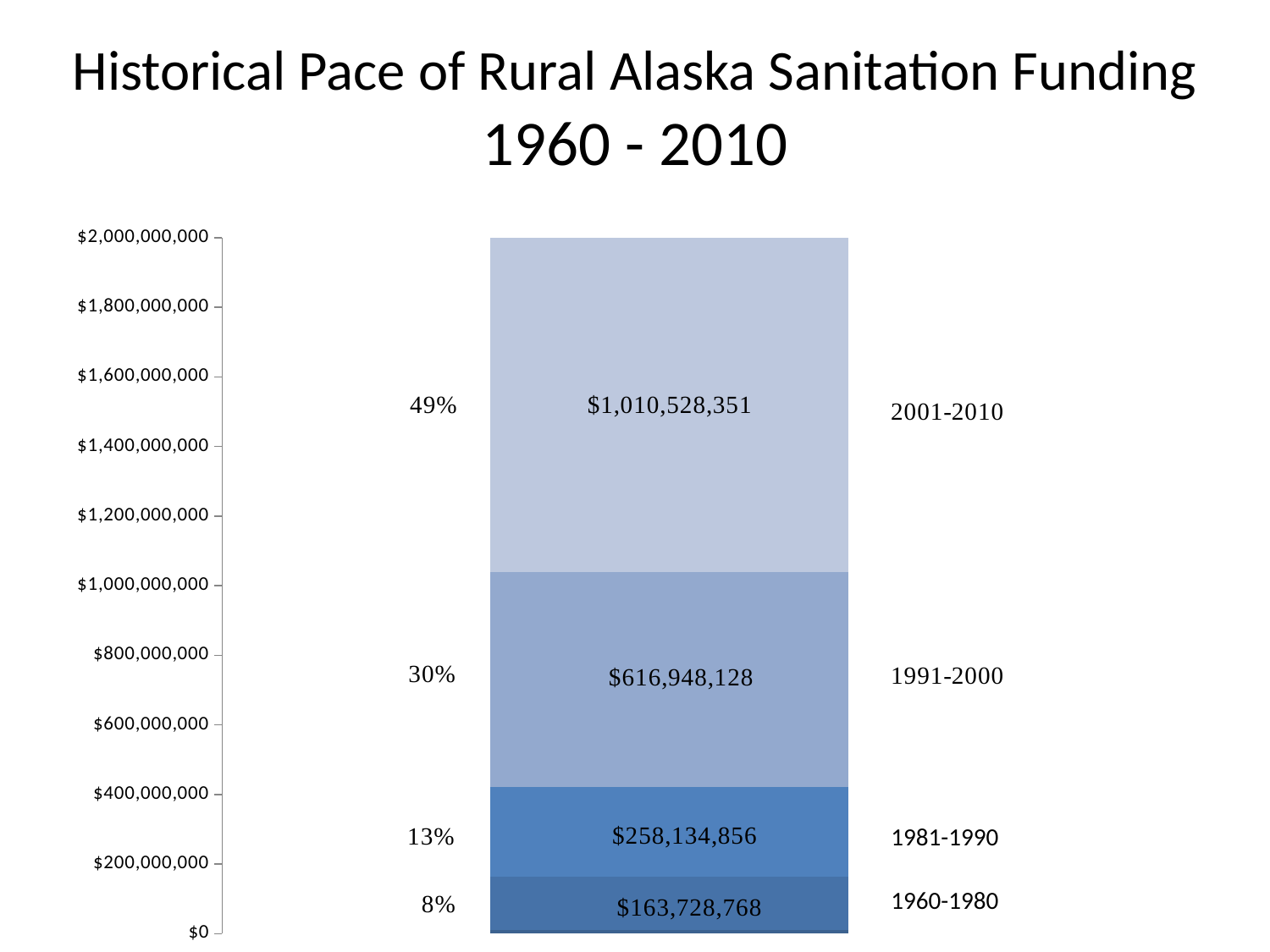
What is the funding amount for the 1981-1990 period? $258,134,856 Which period received the smallest share of funding? 1960-1980 What is the funding amount for the 2001-2010 period? $1,010,528,351 What is the funding amount for the 1960-1980 period? $163,728,768 What is the funding amount for the 1991-2000 period? $616,948,128 What percentage of total funding does the 1991-2000 period represent? 30% Which period received the largest share of funding? 2001-2010 How much more funding did the 2001-2010 period receive than the 1991-2000 period? $393,580,223 What kind of chart is shown on the slide? Stacked bar chart What percentage of total funding does the 1960-1980 period represent? 8% Which period received more funding, 1981-1990 or 1991-2000? 1991-2000 How many time periods are shown in the stacked bar? 4